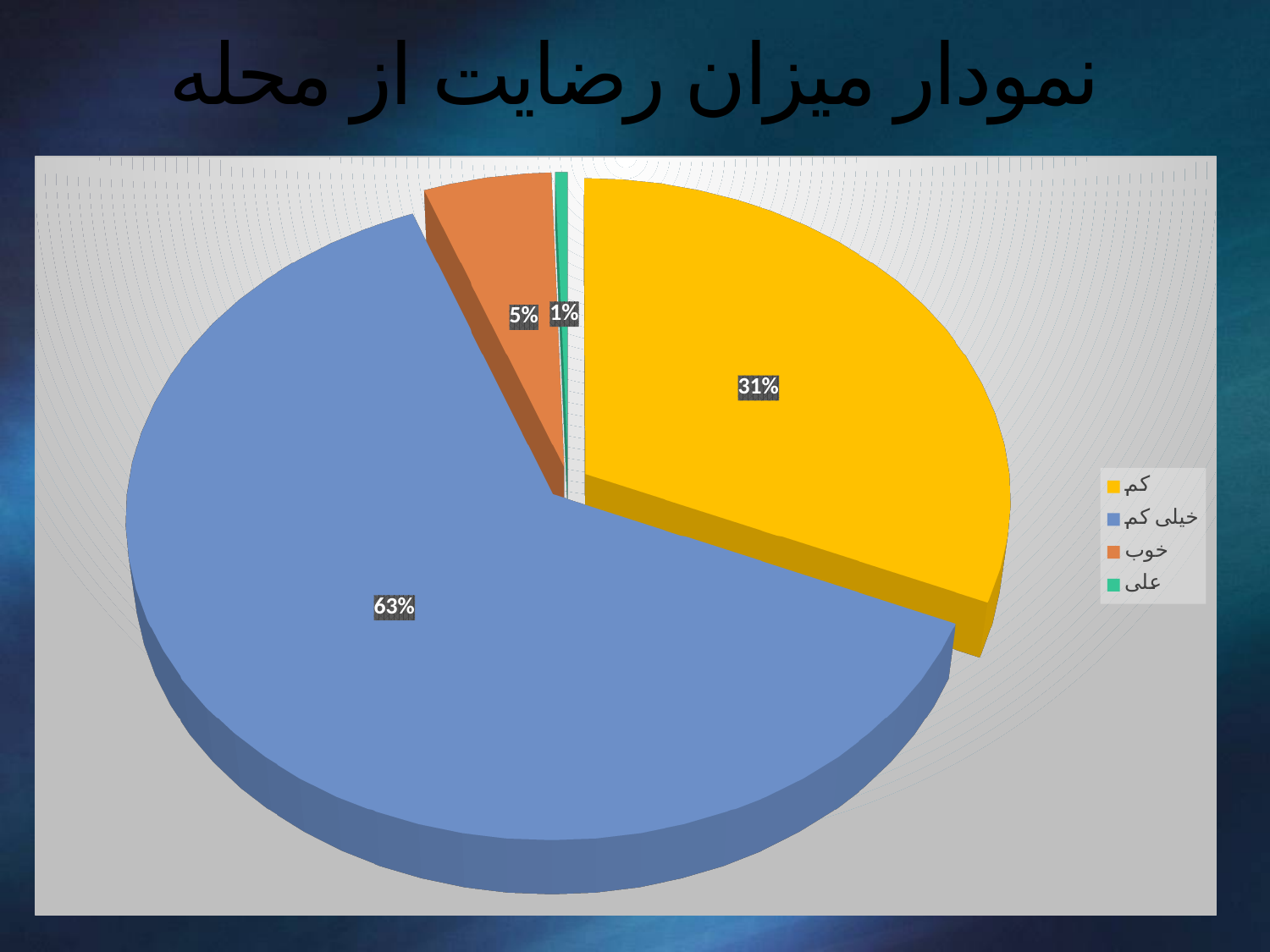
What percentage is shown for the category "علی"? 1% Which is larger, the share for "کم" or the share for "خوب"? کم Which category has the largest share of the pie? خیلی کم What colour is the slice for "خوب"? Orange Which category has the smallest share of the pie? علی What percentage is shown for the category "کم"? 31% What type of chart is shown on the slide? Pie chart What percentage is shown for the category "خوب"? 5% What is the difference in percentage points between "خیلی کم" and "کم"? 32 What is the title of the chart? نمودار میزان رضایت از محله How many categories does the legend list? 4 What percentage is shown for the category "خیلی کم"? 63%